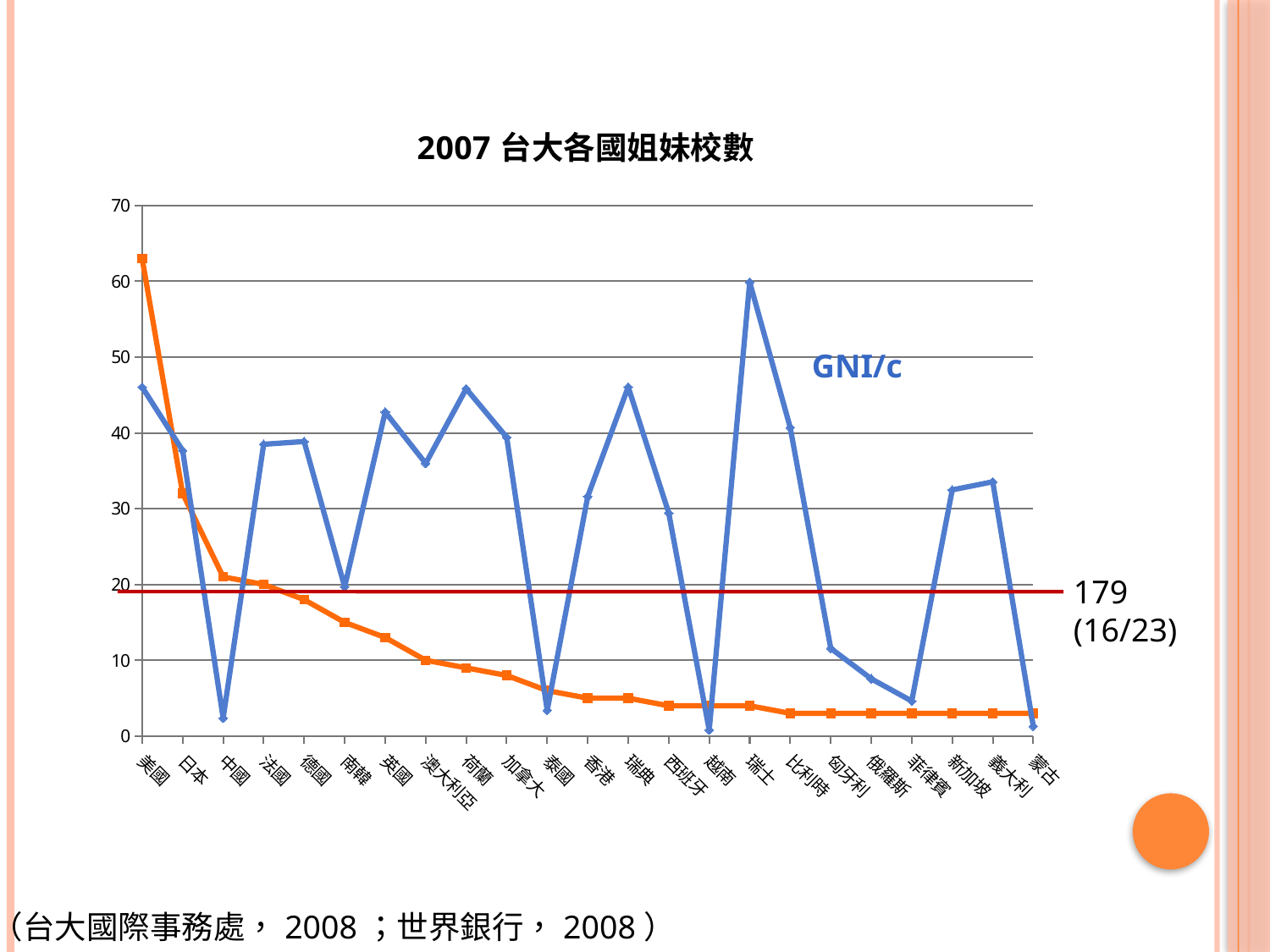
What is the title of the chart? 2007 台大各國姐妹校數 Which country has the highest value on the blue GNI/c line? 瑞士 How many countries are plotted along the x axis? 23 Does the orange line generally rise or fall from left to right along the x axis? fall On the blue GNI/c line, which is larger: the value for 瑞士 or the value for 美國? 瑞士 Is the orange line's value for 南韓 greater or less than 20? less Is the blue GNI/c value for 中國 greater or less than 10? less Is the orange line's value for 美國 greater or less than 60? greater What kind of chart is shown on the slide? line chart Which country has the highest value on the orange line? 美國 Which series label is written next to the blue line? GNI/c